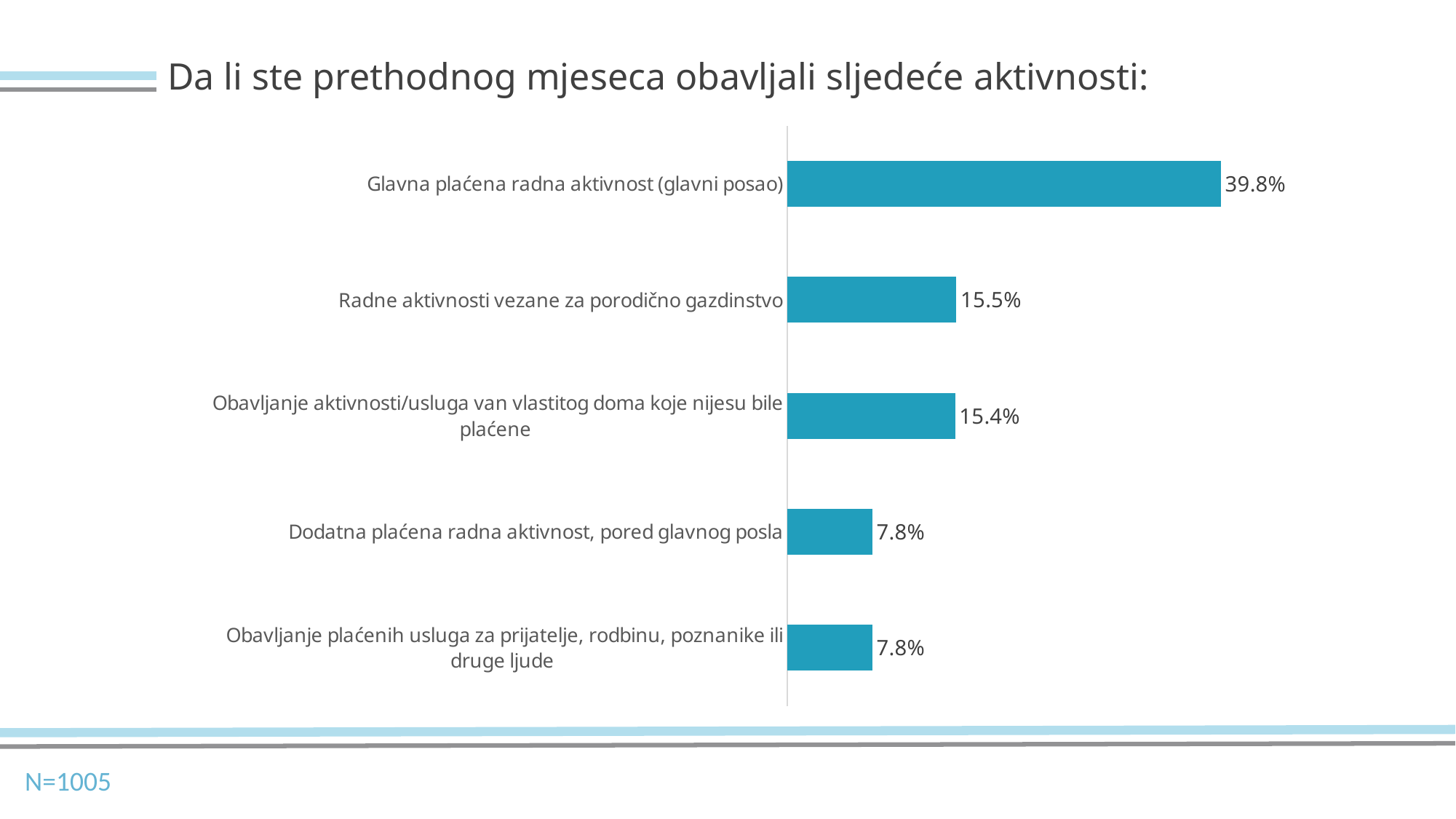
What is the value for "Glavna plaćena radna aktivnost (glavni posao)"? 39.8% Which is larger: the value for "Glavna plaćena radna aktivnost (glavni posao)" or the value for "Dodatna plaćena radna aktivnost, pored glavnog posla"? Glavna plaćena radna aktivnost (glavni posao) What is the value for "Radne aktivnosti vezane za porodično gazdinstvo"? 15.5% What is the title of the chart? Da li ste prethodnog mjeseca obavljali sljedeće aktivnosti: How many categories are shown in the chart? 5 What is the difference between the values for "Radne aktivnosti vezane za porodično gazdinstvo" and "Dodatna plaćena radna aktivnost, pored glavnog posla"? 7.7% What is the value for "Dodatna plaćena radna aktivnost, pored glavnog posla"? 7.8% What is the value for "Obavljanje aktivnosti/usluga van vlastitog doma koje nijesu bile plaćene"? 15.4% What is the difference between the values for "Glavna plaćena radna aktivnost (glavni posao)" and "Radne aktivnosti vezane za porodično gazdinstvo"? 24.3% What sample size (N) is stated on the slide? N=1005 What kind of chart is shown on the slide? Bar chart Which category has the highest value? Glavna plaćena radna aktivnost (glavni posao)